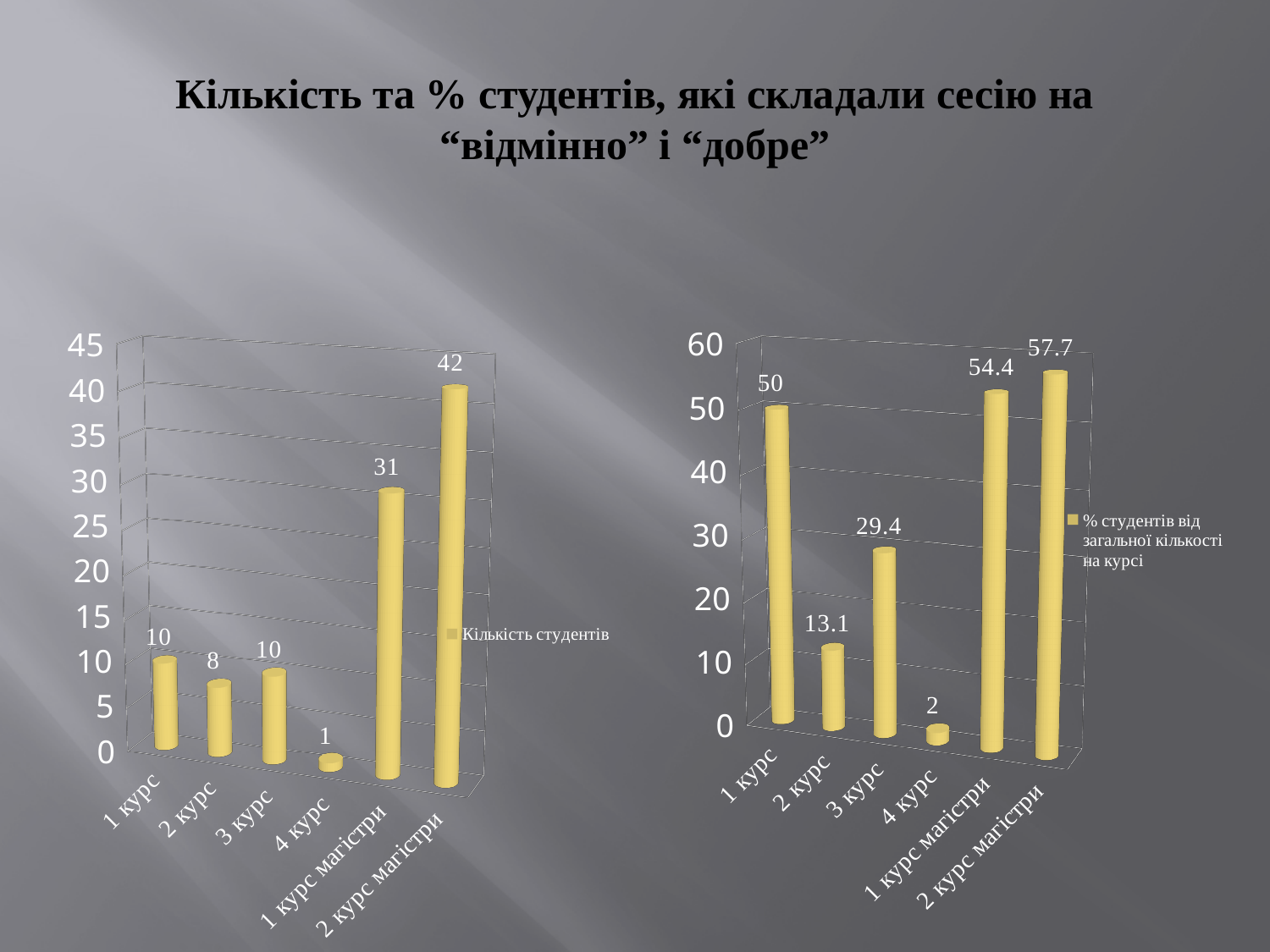
In the left chart (Кількість студентів), which category has the highest value? 2 курс магістри In the right chart (% студентів від загальної кількості на курсі), what is the difference between the values for 1 курс and 2 курс? 36.9 In the right chart (% студентів від загальної кількості на курсі), what is the value for 2 курс? 13.1 In the right chart (% студентів від загальної кількості на курсі), which is larger: the value for 1 курс or the value for 1 курс магістри? 1 курс магістри What kind of chart is the left chart (Кількість студентів)? Bar chart In the left chart (Кількість студентів), what is the value for 1 курс магістри? 31 In the right chart (% студентів від загальної кількості на курсі), which category has the highest value? 2 курс магістри How many series does the legend of the right chart list? 1 In the right chart (% студентів від загальної кількості на курсі), what is the value for 3 курс? 29.4 In the left chart (Кількість студентів), which category has the lowest value? 4 курс In the left chart (Кількість студентів), what is the difference between the values for 2 курс магістри and 1 курс магістри? 11 In the left chart (Кількість студентів), how many categories are shown on the x axis? 6